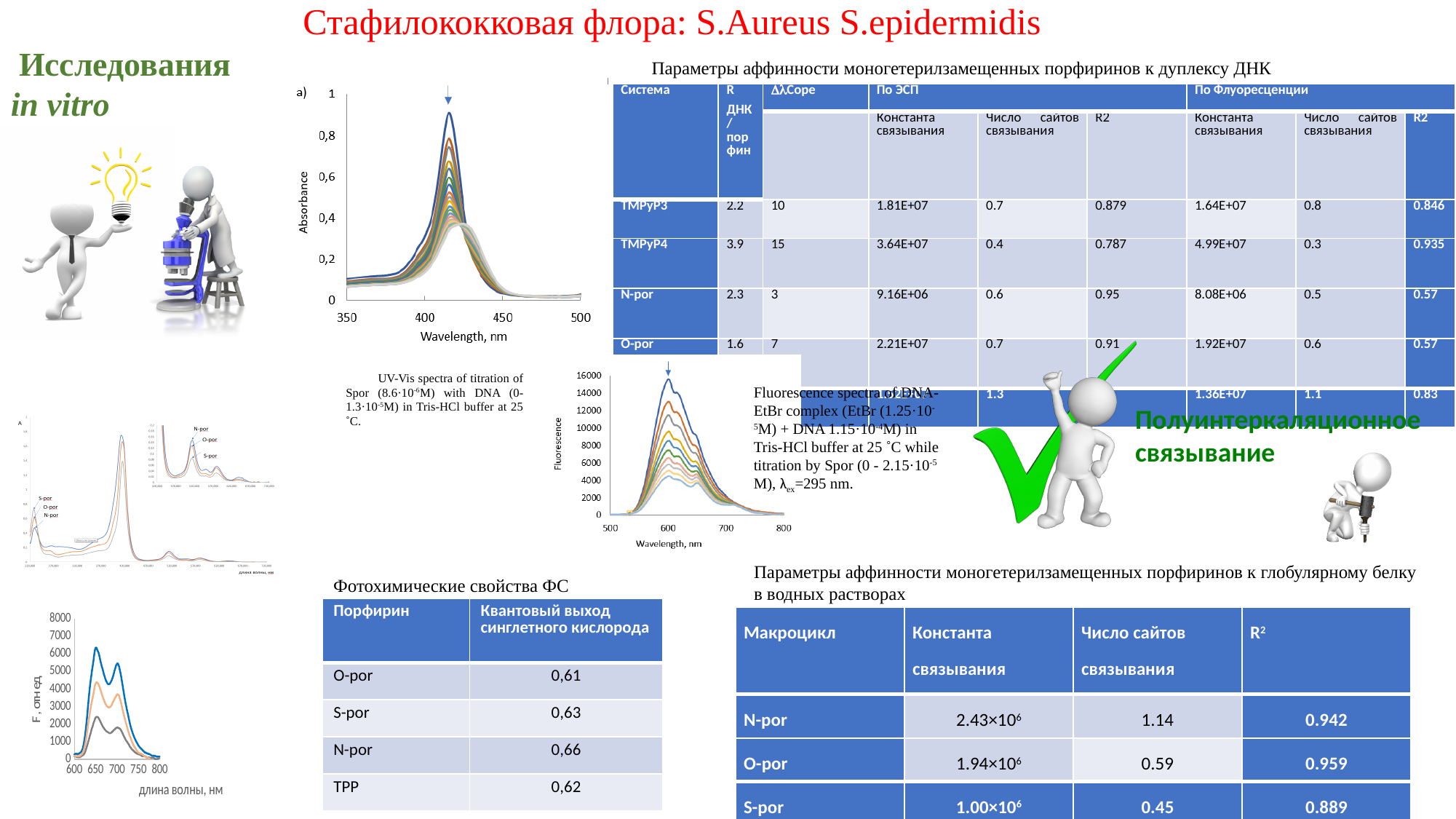
How many series are labelled in the spectra chart on the left middle of the slide (N-por, O-por, S-por)? 3 What is the y-axis label of the UV-Vis absorbance chart labelled 'a)'? Absorbance How many curves are plotted in the fluorescence chart at the bottom left of the slide (y-axis 'F, отн ед')? 3 In the UV-Vis absorbance chart labelled 'a)', is the peak absorbance of the highest curve greater or less than 0.8? greater In the fluorescence spectra chart in the middle of the slide, near which x-axis tick does the peak of the curves occur? 600 What kind of chart is the UV-Vis absorbance chart labelled 'a)' at the top middle of the slide? line chart In the UV-Vis absorbance chart labelled 'a)', is the peak absorbance of the lowest (grey) curve greater or less than 0.6? less In the fluorescence chart at the bottom left of the slide (y-axis 'F, отн ед'), is the peak of the blue curve greater or less than 5000? greater What is the x-axis label of the fluorescence spectra chart in the middle of the slide? Wavelength, nm In the fluorescence chart at the bottom left of the slide (y-axis 'F, отн ед'), which curve reaches the highest value: the blue or the grey one? blue